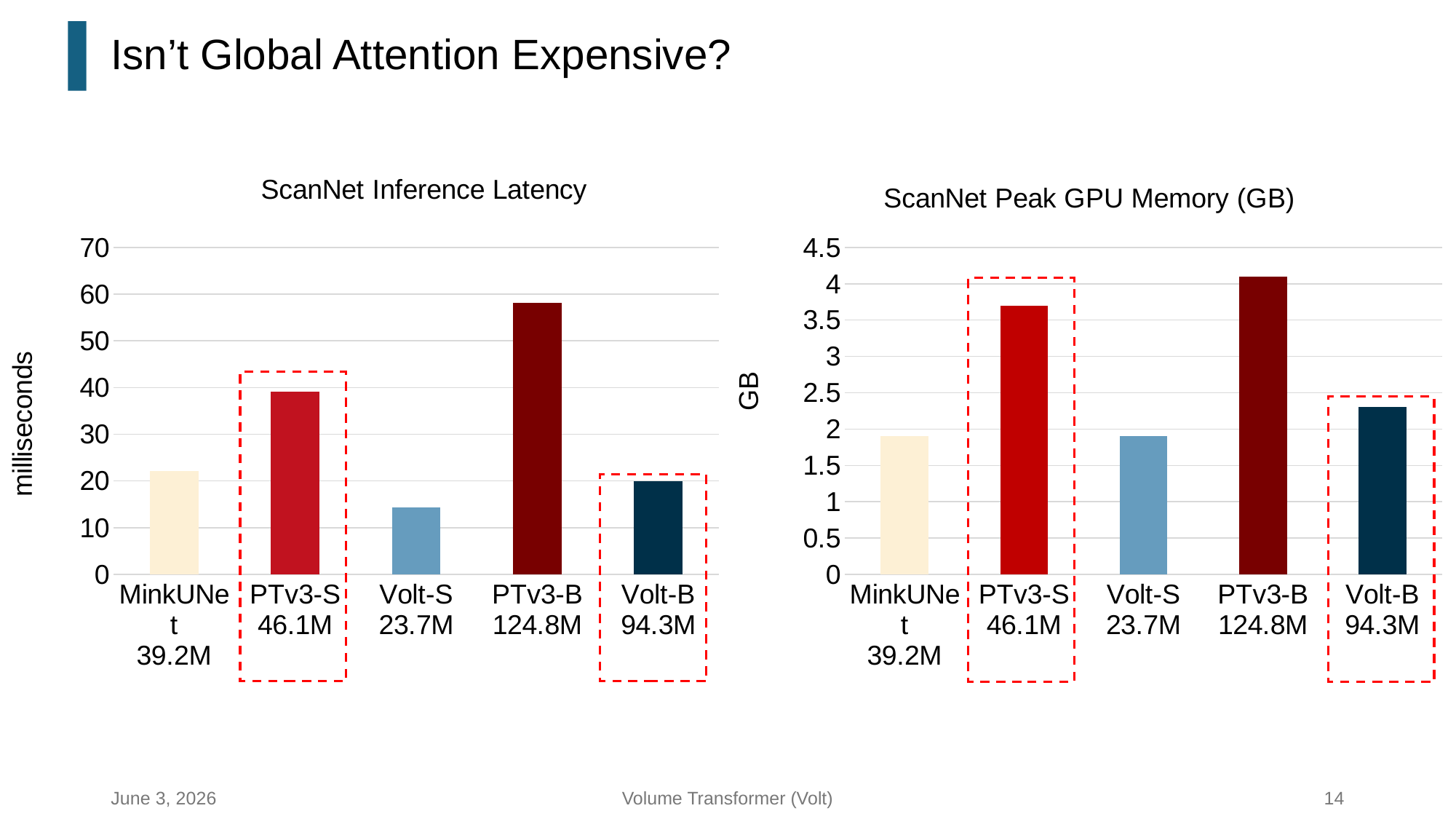
What kind of chart is the ScanNet Peak GPU Memory (GB) chart? bar chart How many models are shown in the ScanNet Inference Latency chart? 5 In the ScanNet Inference Latency chart, which model has the lowest latency? Volt-S What is the y-axis label of the ScanNet Inference Latency chart? milliseconds In the ScanNet Inference Latency chart, is the value for Volt-B greater or less than 30? less In the ScanNet Peak GPU Memory (GB) chart, which uses more memory, PTv3-S or Volt-B? PTv3-S In the ScanNet Peak GPU Memory (GB) chart, is the value for Volt-B greater or less than 3? less In the ScanNet Peak GPU Memory (GB) chart, is the value for PTv3-S greater or less than 3? greater In the ScanNet Inference Latency chart, which has the higher latency, PTv3-S or Volt-B? PTv3-S In the ScanNet Inference Latency chart, which model has the highest latency? PTv3-B In the ScanNet Peak GPU Memory (GB) chart, which model uses the most memory? PTv3-B